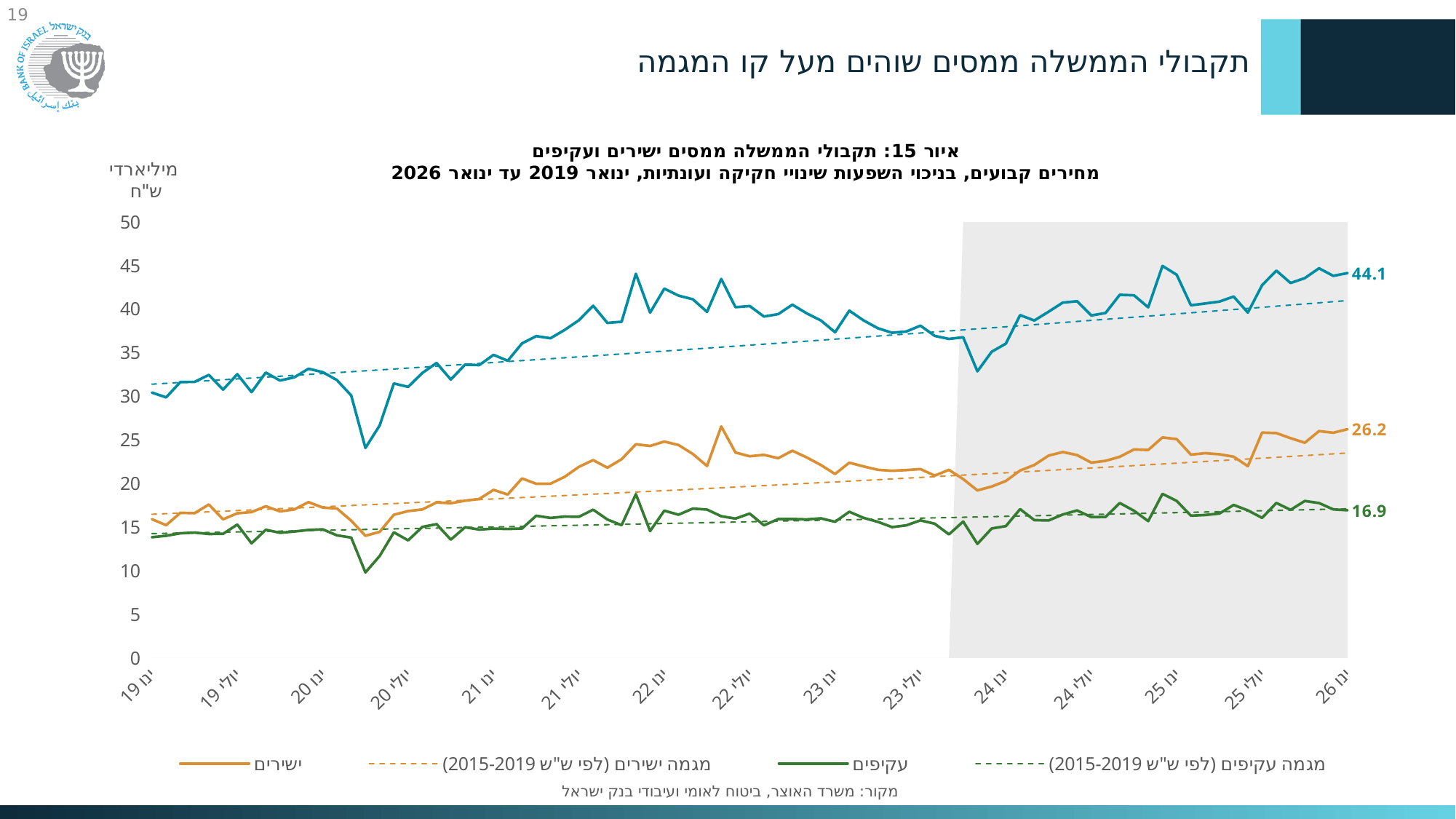
Which line has the higher final labelled value, the orange ישירים line or the green עקיפים line? ישירים (orange) What unit is shown on the y-axis label of the chart? מיליארדי ש"ח Is the value of the green עקיפים line at its lowest point in 2020 greater or less than 15? less How many entries does the legend list? 4 Is the value of the blue line at the start of the chart (ינו 19) greater or less than 35? less What is the difference between the final labelled values of the blue line (44.1) and the orange line (26.2)? 17.9 What kind of chart is shown on the slide? Line chart What is the final labelled value of the top blue line at the right end of the chart? 44.1 Overall, does the orange ישירים line rise or fall from ינו 19 to ינו 26? Rise What is the difference between the final labelled values of the orange line (26.2) and the green line (16.9)? 9.3 What is the final labelled value of the green line (עקיפים) at the right end of the chart? 16.9 What is the final labelled value of the orange line (ישירים) at the right end of the chart? 26.2